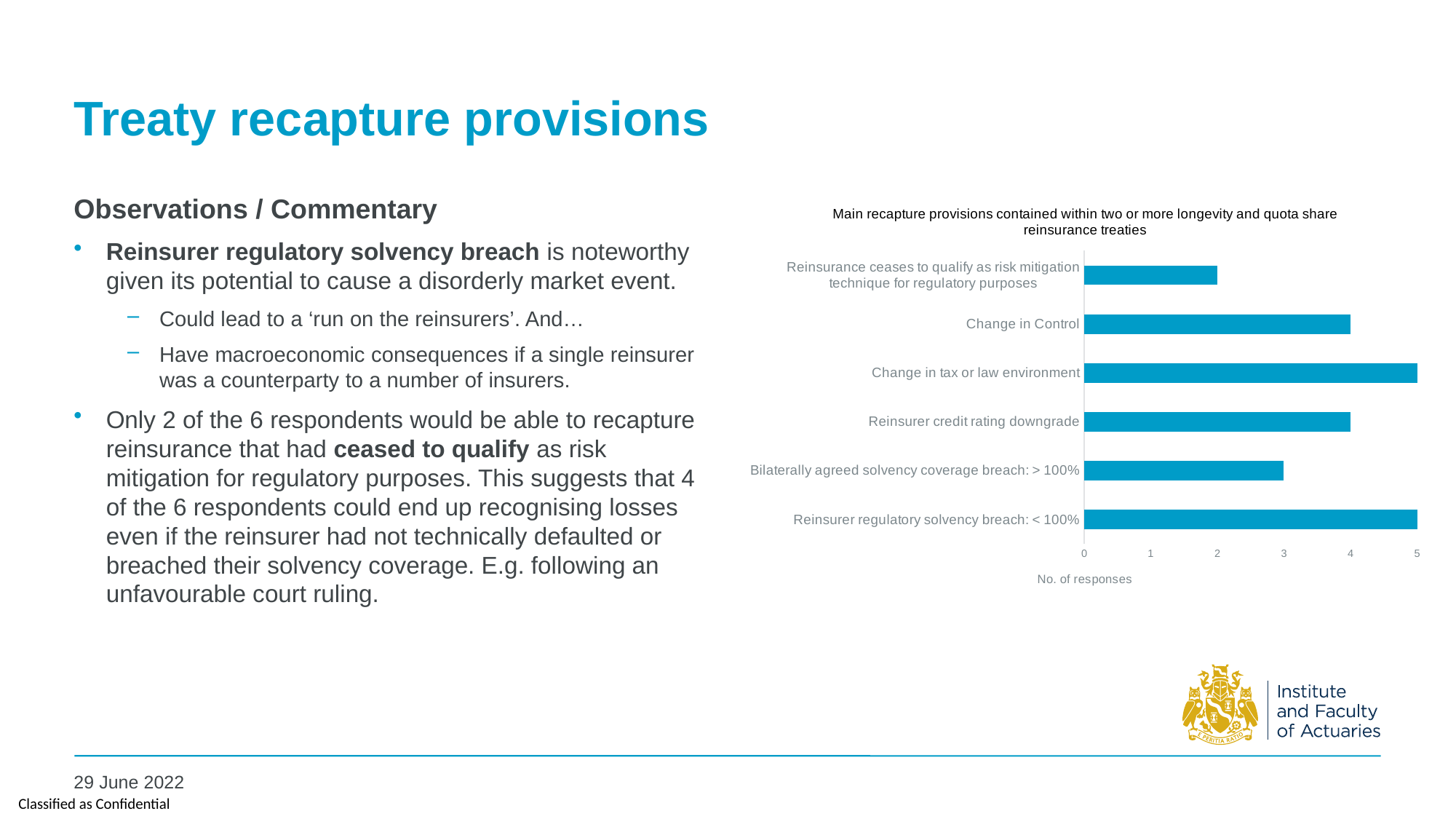
What is the label on the horizontal axis of the chart? No. of responses What is the difference in responses between 'Reinsurer regulatory solvency breach: < 100%' and 'Bilaterally agreed solvency coverage breach: > 100%'? 2 Is the value for 'Change in Control' greater or less than 3? greater What is the number of responses for 'Bilaterally agreed solvency coverage breach: > 100%'? 3 What is the number of responses for 'Reinsurance ceases to qualify as risk mitigation technique for regulatory purposes'? 2 What is the number of responses for 'Change in tax or law environment'? 5 What is the title of the chart? Main recapture provisions contained within two or more longevity and quota share reinsurance treaties Which category has the lowest number of responses? Reinsurance ceases to qualify as risk mitigation technique for regulatory purposes How many categories are plotted in the chart? 6 What type of chart is shown on the slide? Bar chart What is the number of responses for 'Change in Control'? 4 Which has more responses: 'Reinsurer credit rating downgrade' or 'Reinsurance ceases to qualify as risk mitigation technique for regulatory purposes'? Reinsurer credit rating downgrade